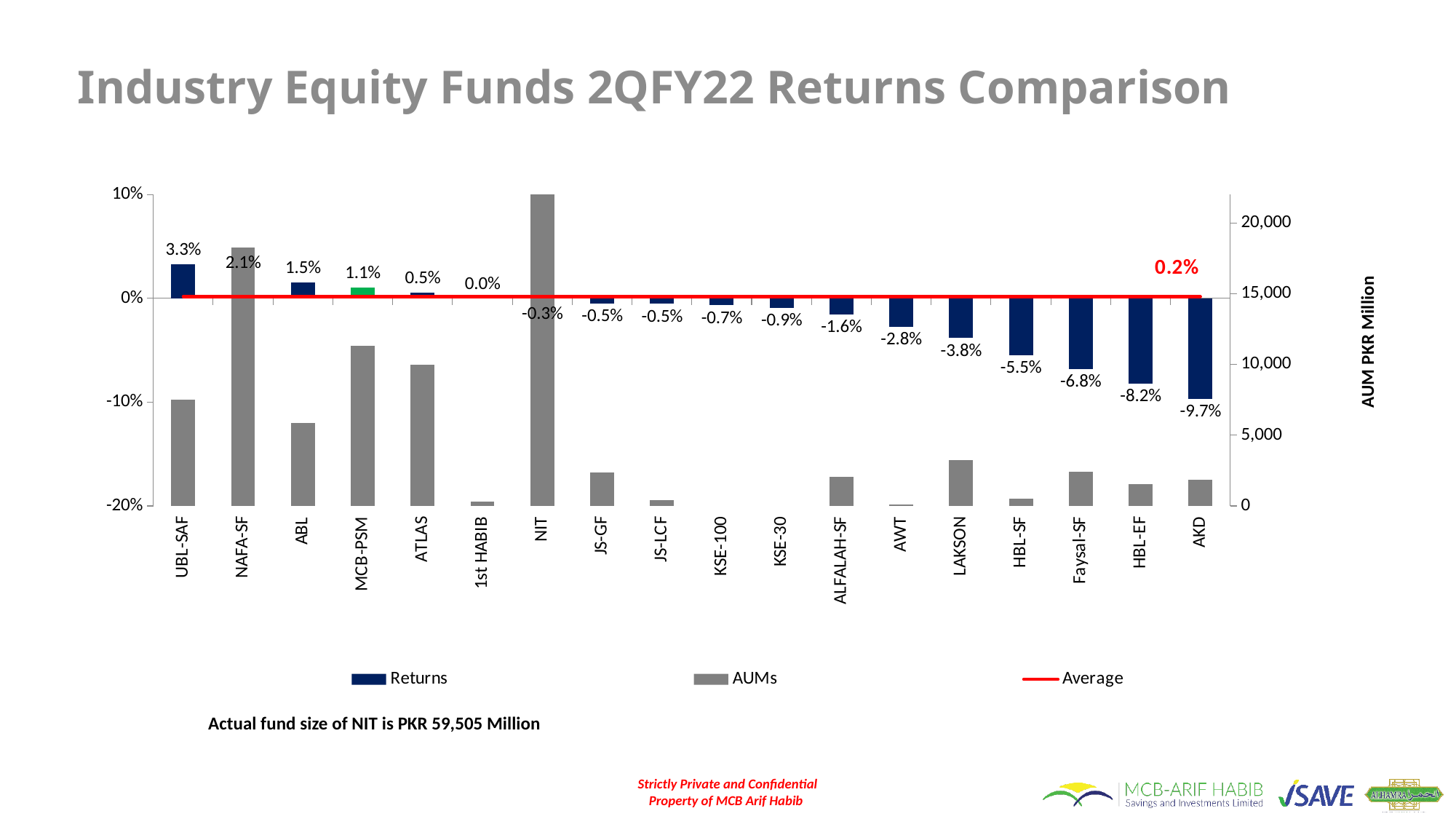
How many series does the legend list? 3 Is the AUM for UBL-SAF greater or less than 10,000? less What is the return for ALFALAH-SF? -1.6% Which fund has the lowest return? AKD What is the difference between the returns of UBL-SAF and NAFA-SF? 1.2% Is the AUM for NAFA-SF greater or less than 15,000? greater Which fund has the highest return? UBL-SAF What is the return for UBL-SAF? 3.3% What is the value of the Average line? 0.2% Which has the larger return, ABL or MCB-PSM? ABL How many funds are shown on the x axis? 18 What is the return for HBL-EF? -8.2%